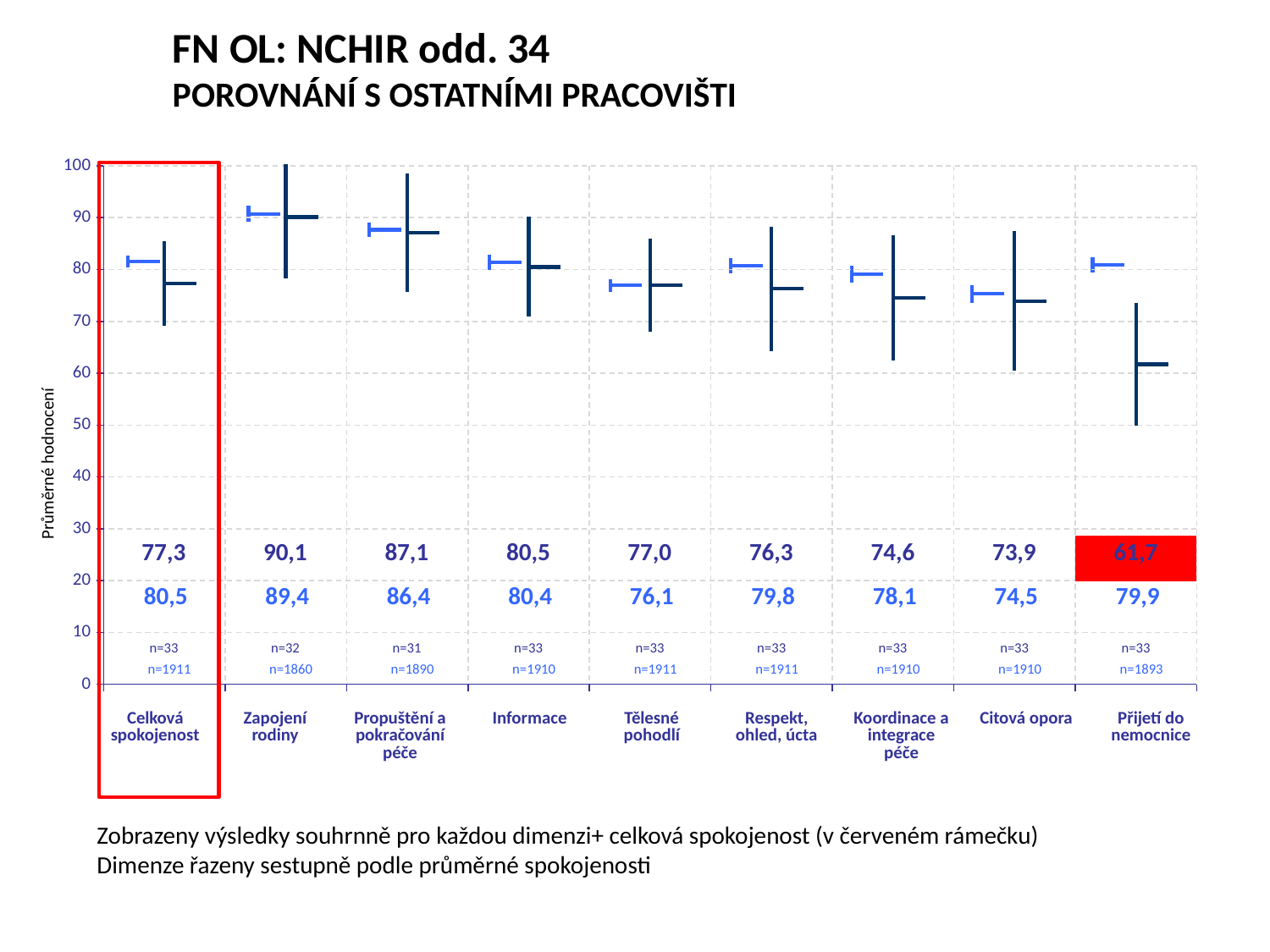
What is the n value printed in the first n row for Propuštění a pokračování péče? n=31 How many categories are shown on the x axis? 9 What is the dark blue (upper) value printed for Přijetí do nemocnice? 61,7 What is the light blue (lower) value printed for Informace? 80,4 What is the difference between the light blue value (80,5) and the dark blue value (77,3) for Celková spokojenost? 3,2 What is the dark blue (upper) value printed for Zapojení rodiny? 90,1 What is the title of the y axis? Průměrné hodnocení For Respekt, ohled, úcta, which is larger: the dark blue value (76,3) or the light blue value (79,8)? the light blue value (79,8) Which category has the highest dark blue (upper) value? Zapojení rodiny Do the dark blue (upper) values rise or fall from Zapojení rodiny to Přijetí do nemocnice? fall What is the difference between the light blue value (79,9) and the dark blue value (61,7) for Přijetí do nemocnice? 18,2 Which category has the lowest dark blue (upper) value? Přijetí do nemocnice